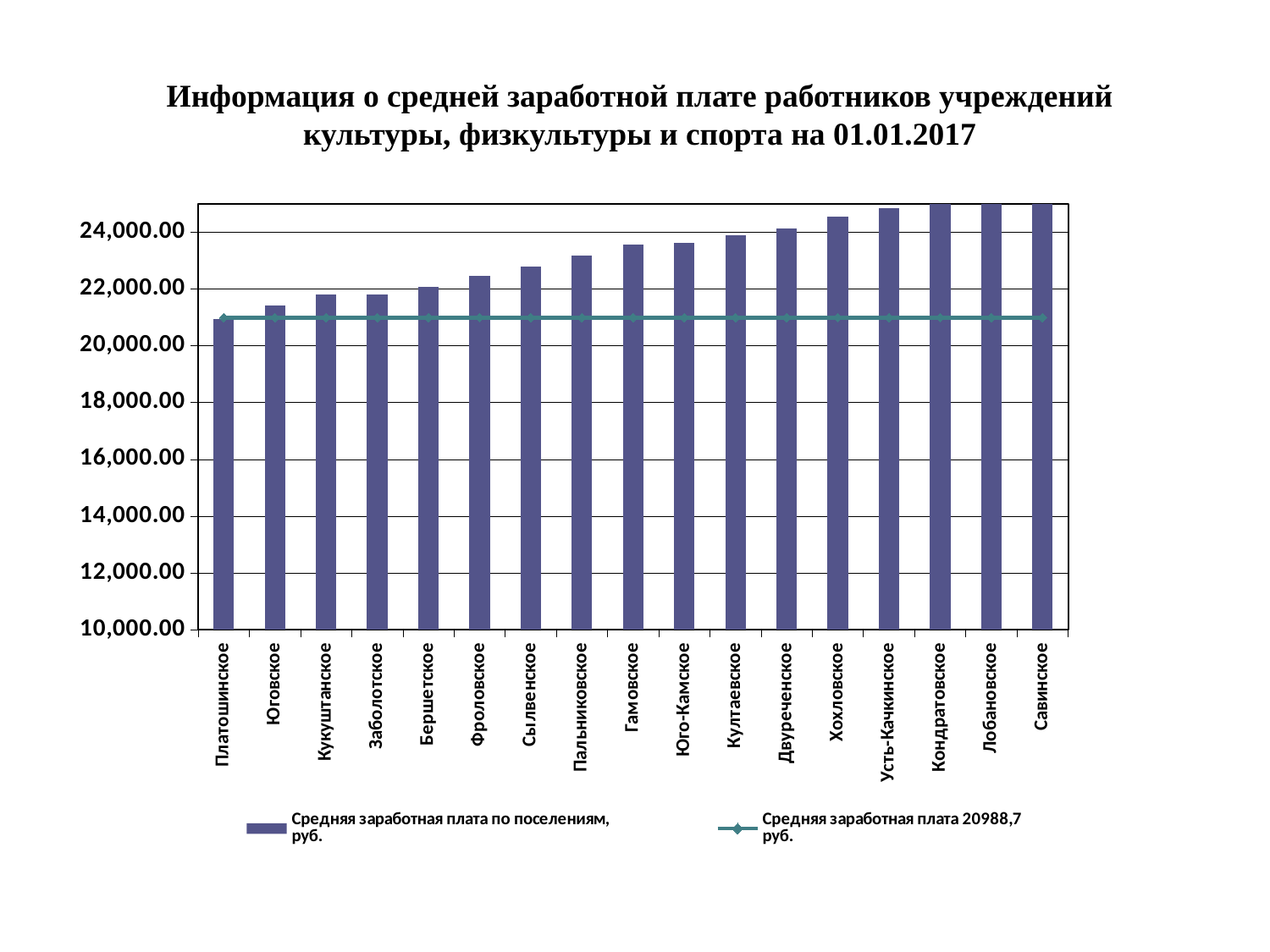
Is the value for Платошинское greater or less than 22,000.00? less What is the legend label of the bar series? Средняя заработная плата по поселениям, руб. Is the value for Фроловское greater or less than 22,000.00? greater Do the bar values rise or fall from left to right along the x axis? rise How many settlements (categories) are shown on the x axis? 17 What kind of chart is shown on the slide? combination bar and line chart Is the value for Сылвенское greater or less than 24,000.00? less What average salary value does the horizontal line series represent, according to the legend? 20988,7 руб. How many series does the legend list? 2 Which has the larger average salary bar, Юговское or Хохловское? Хохловское Which settlement has the lowest average salary bar? Платошинское